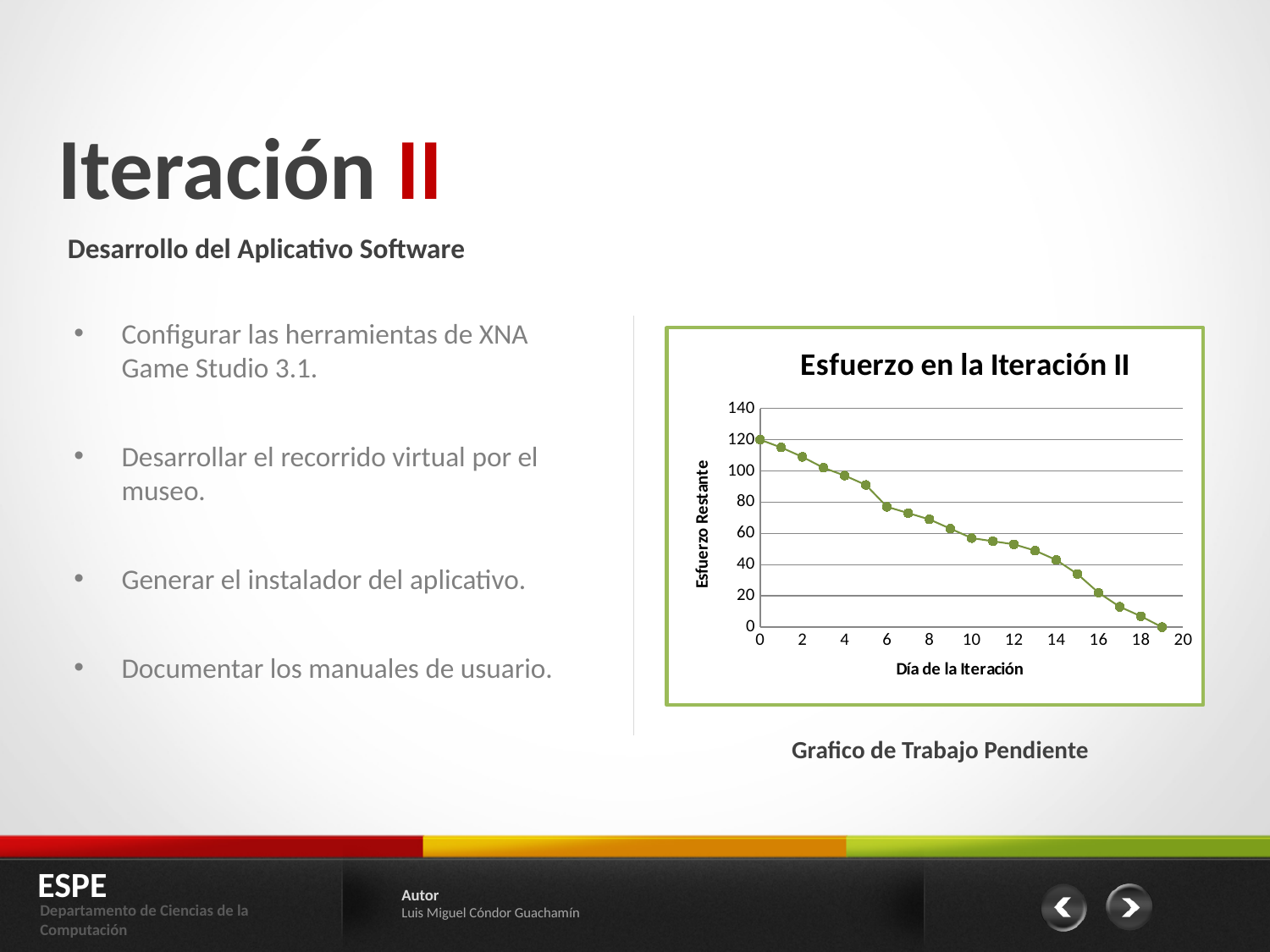
What is the label of the y axis of the chart? Esfuerzo Restante What is the title of the chart? Esfuerzo en la Iteración II Which is larger, the Esfuerzo Restante value at day 8 or at day 14? day 8 Which day has the highest Esfuerzo Restante value? 0 Do the values rise or fall as the day of the iteration increases? fall What is the Esfuerzo Restante value at day 0? 120 Is the Esfuerzo Restante value at day 12 greater or less than 40? greater Is the Esfuerzo Restante value at day 6 greater or less than 60? greater Is the Esfuerzo Restante value at day 18 greater or less than 20? less What kind of chart is shown on the slide? line chart